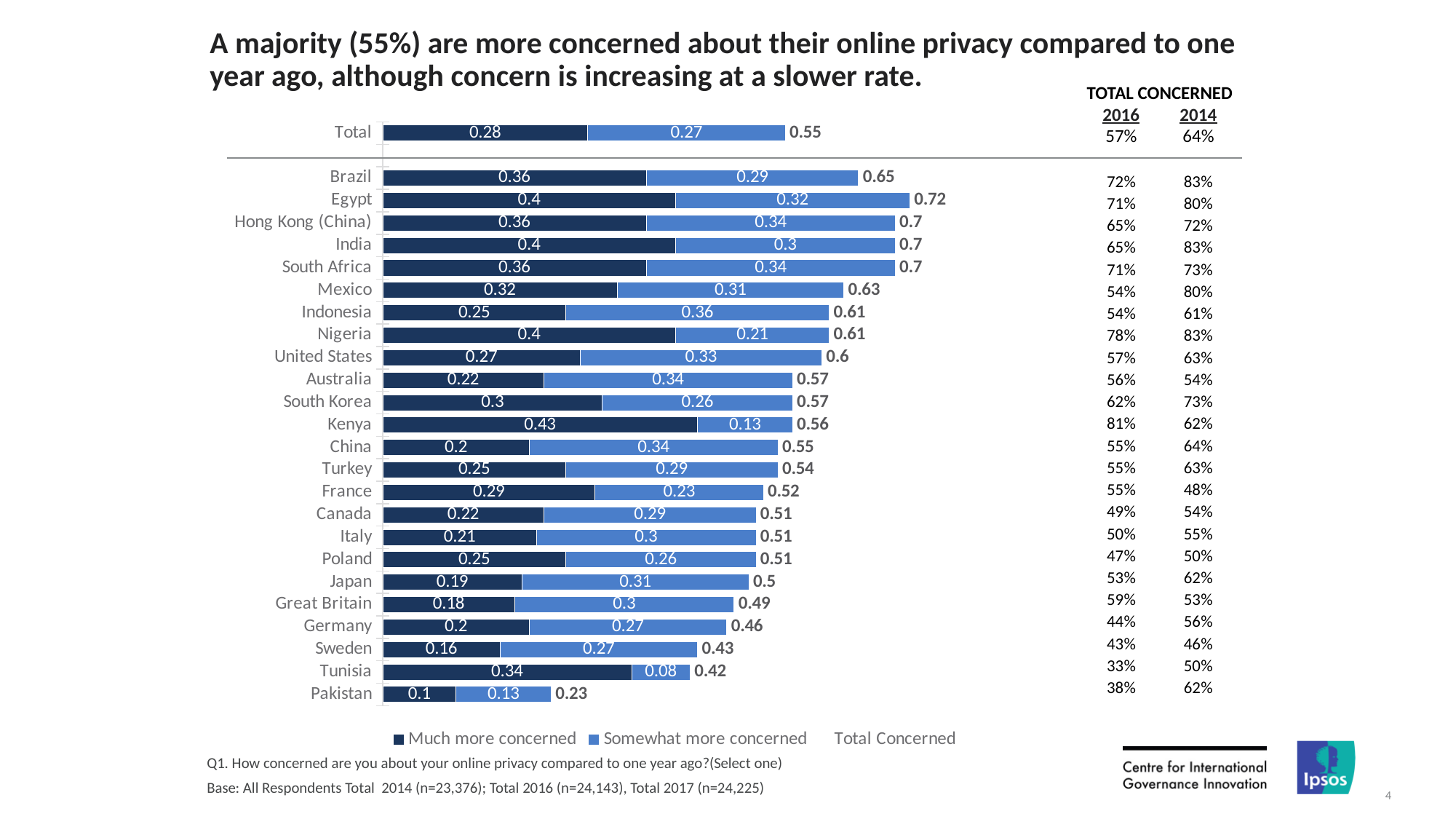
What is the 'Much more concerned' value for Kenya? 0.43 Which country has the highest Total Concerned value? Egypt How many entries does the legend list? 3 What is the Total Concerned value for Egypt? 0.72 What is the total of the stacked bar for Sweden? 0.43 What is the 'Somewhat more concerned' value for Indonesia? 0.36 Which country has the lowest Total Concerned value? Pakistan What kind of chart is shown on the slide? Stacked bar chart How many country bars are shown below the Total bar? 24 Which country has the lowest 'Somewhat more concerned' value? Tunisia Which has a larger 'Much more concerned' value, Nigeria or Indonesia? Nigeria What is the difference between the Total Concerned values for Brazil and Mexico? 0.02